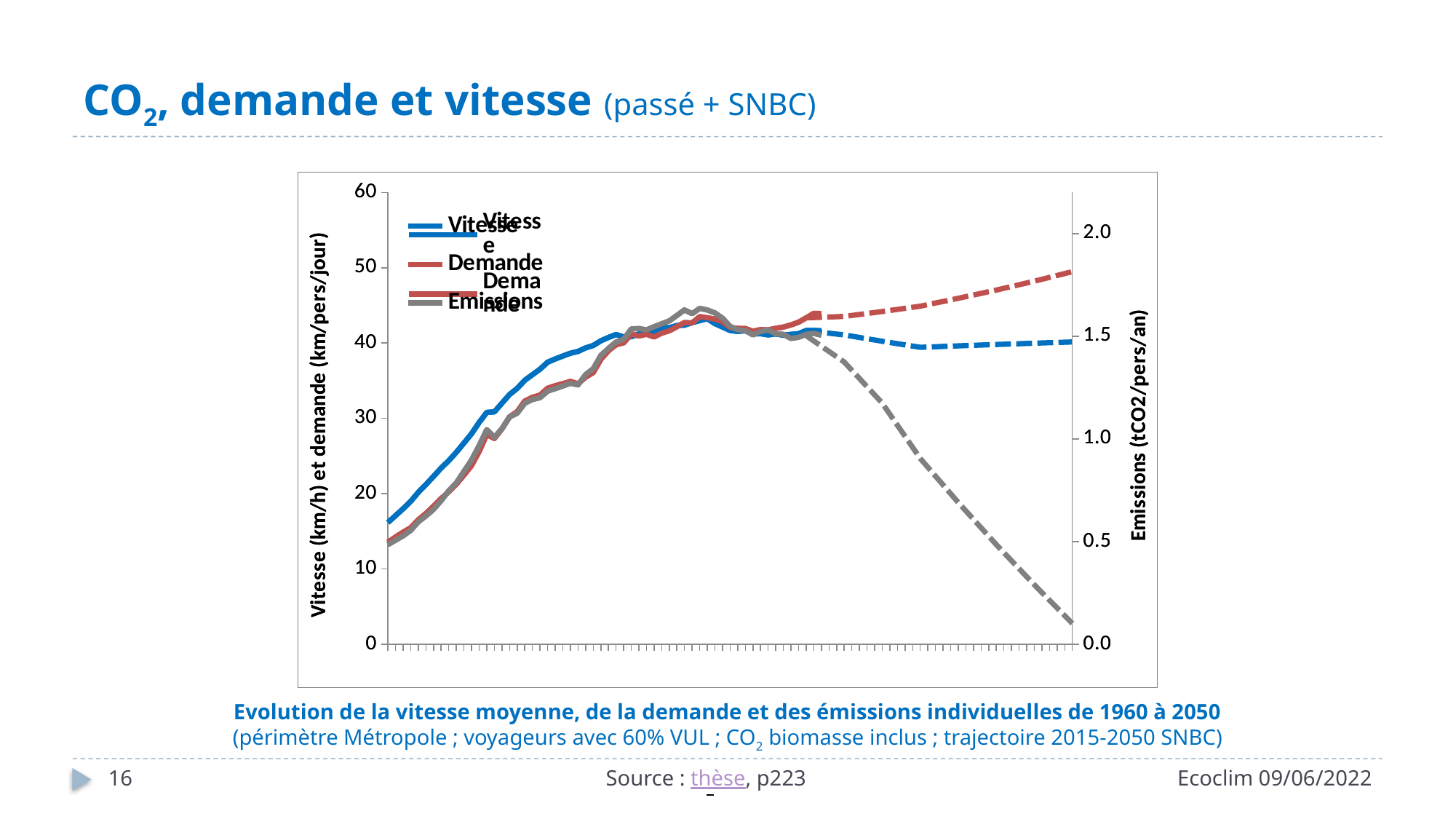
What is the title of the right-hand vertical axis? Emissions (tCO2/pers/an) Is the value of Demande at the right end of the chart greater or less than 40? greater Does the Demande line rise or fall over the dashed (projected) part of the chart? rise Which series are listed in the chart's legend? Vitesse, Demande, Emissions At the right end of the chart, which is higher on the left axis: Vitesse or Demande? Demande What is the highest tick value shown on the left vertical axis? 60 What kind of chart is shown on the slide? line chart Is the value of Vitesse at the left end of the chart greater or less than 20? less Is the value of Emissions at the right end of the chart greater or less than 0.5? less Does the Emissions line rise or fall over the dashed (projected) part of the chart? fall